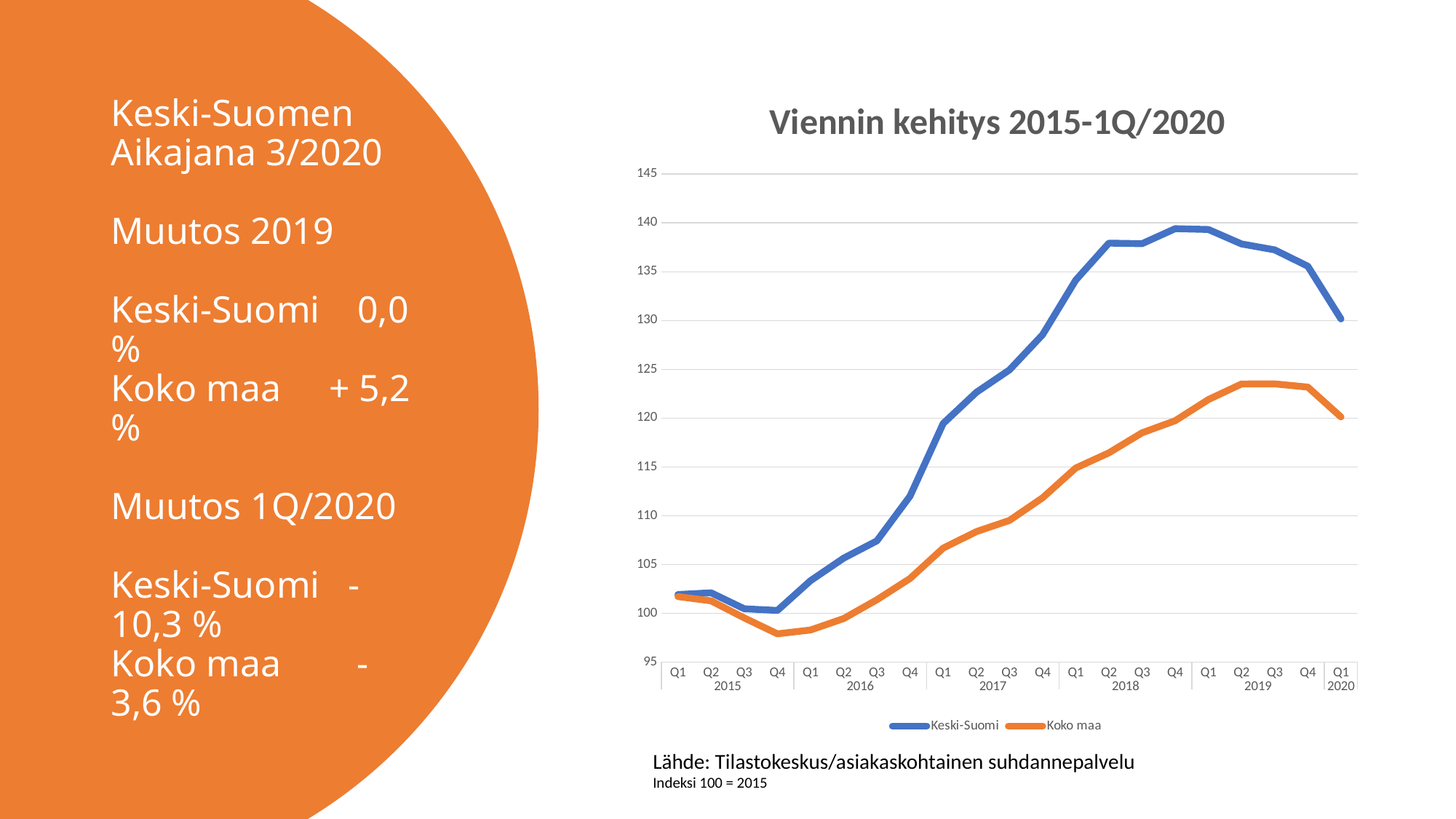
Is the value for Keski-Suomi in Q4 2018 greater or less than 135? greater Is the value for Koko maa in Q4 2017 greater or less than 110? greater How many quarterly points are plotted along the x axis of the chart? 21 Does the Keski-Suomi line rise or fall from Q4 2018 to Q1 2020? fall What kind of chart is shown on the slide? line chart Which series reaches the highest value in the chart? Keski-Suomi Is the value for Koko maa in Q2 2019 greater or less than 120? greater How many series does the legend of the chart list? 2 Which series is drawn in orange in the chart? Koko maa What is the title of the chart? Viennin kehitys 2015-1Q/2020 In Q4 2018, which series has the higher value, Keski-Suomi or Koko maa? Keski-Suomi